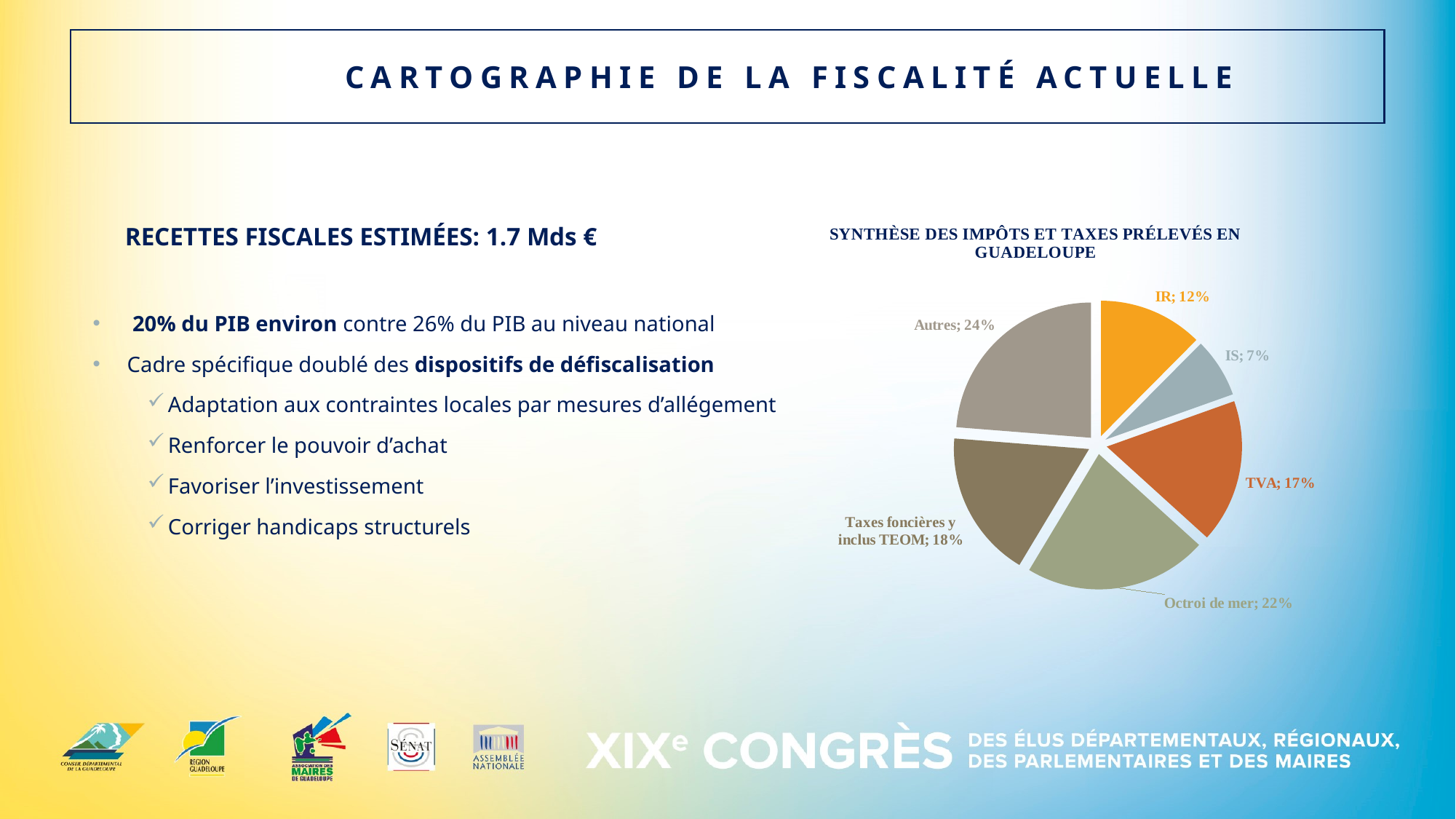
Which category has the largest slice of the pie? Autres What kind of chart is shown on the slide? Pie chart How many slices does the pie chart have? 6 Which category has the smallest slice of the pie? IS What share of the pie does Octroi de mer represent? 22% What is the title of the chart? SYNTHÈSE DES IMPÔTS ET TAXES PRÉLEVÉS EN GUADELOUPE Which is larger, the share for TVA or the share for IR? TVA What is the difference in percentage points between Autres and IS? 17 What share of the pie does 'Taxes foncières y inclus TEOM' represent? 18% What share of the pie does IS represent? 7% What share of the pie does TVA represent? 17% What share of the pie does IR represent? 12%